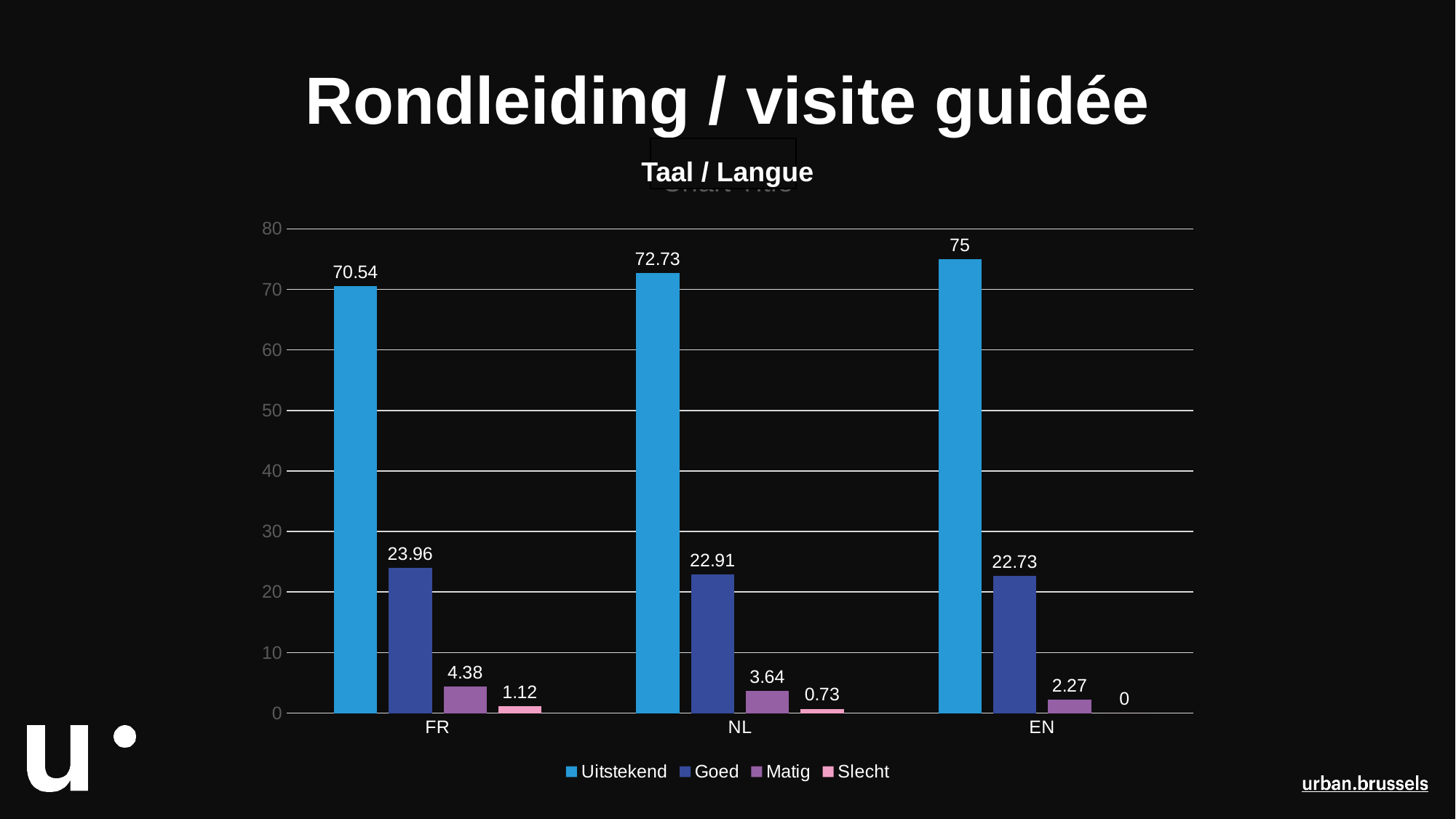
Which is larger: the Matig value for NL or the Matig value for EN? NL What is the value for Goed in the NL category? 22.91 How many series does the legend list? 4 What is the value for Matig in the FR category? 4.38 Do the Goed values rise or fall from FR to EN along the x axis? Fall What is the difference between the Uitstekend values for NL and FR? 2.19 What is the value for Slecht in the EN category? 0 What is the value for Uitstekend in the FR category? 70.54 How many categories are shown on the x axis? 3 Which category has the lowest Goed value? EN What kind of chart is shown on the slide? Bar chart Which category has the highest Uitstekend value? EN